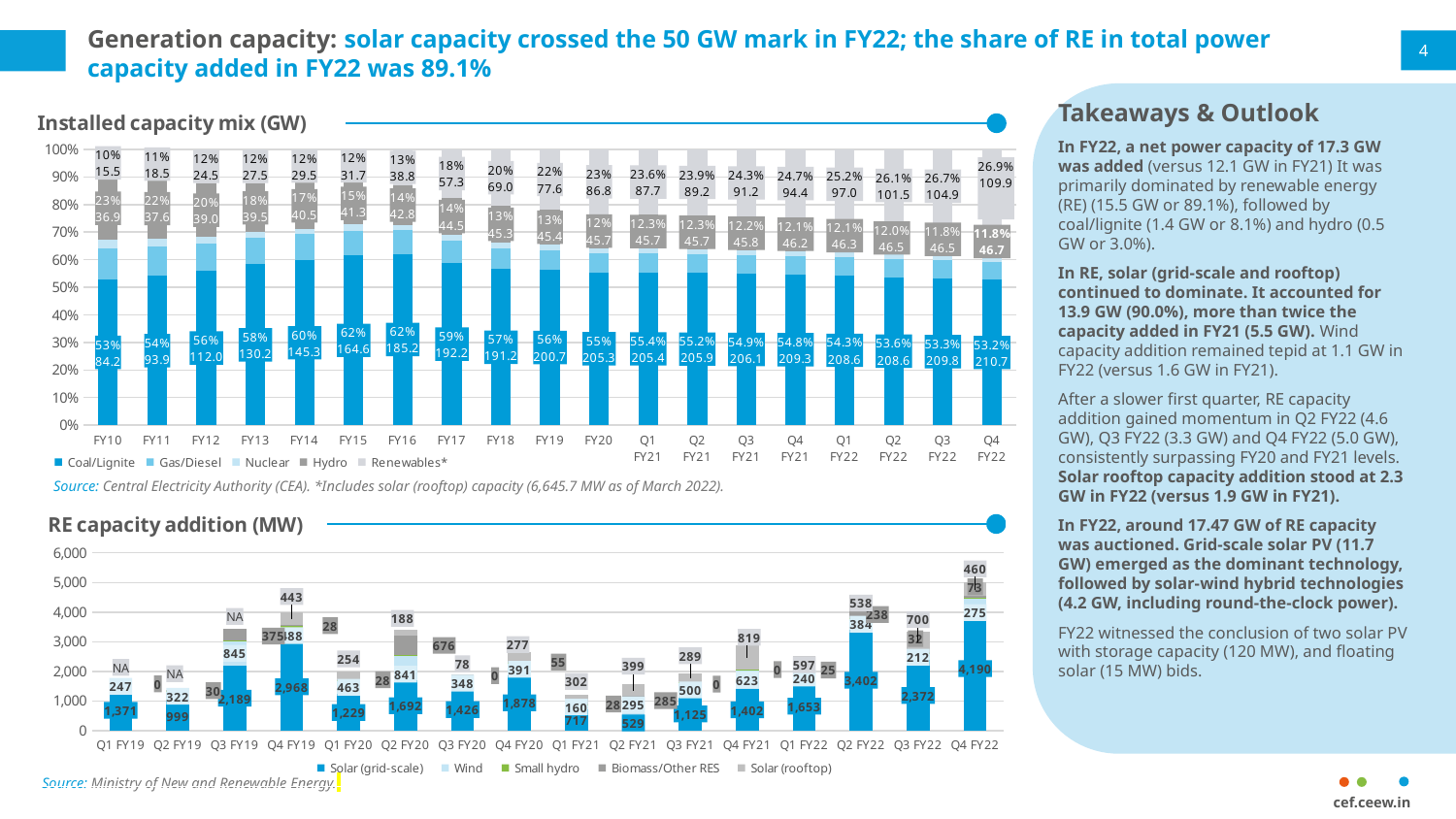
In the 'Installed capacity mix (GW)' chart, what is the Coal/Lignite capacity for FY10? 84.2 In the 'Installed capacity mix (GW)' chart, does the Renewables share rise or fall from FY10 to Q4 FY22? Rise In the 'RE capacity addition (MW)' chart, what is the Solar (rooftop) value for Q4 FY21? 819 What kind of chart is the 'Installed capacity mix (GW)' chart? Stacked bar chart In the 'Installed capacity mix (GW)' chart, how many series does the legend list? 5 In the 'Installed capacity mix (GW)' chart, how many periods are shown on the x axis? 19 In the 'Installed capacity mix (GW)' chart, what percentage share does Renewables have in FY17? 18% In the 'RE capacity addition (MW)' chart, which quarter has the highest Solar (grid-scale) addition? Q4 FY22 In the 'RE capacity addition (MW)' chart, how many quarters are shown on the x axis? 16 In the 'Installed capacity mix (GW)' chart, what is the difference in Renewables capacity between Q4 FY22 and FY10? 94.4 In the 'RE capacity addition (MW)' chart, what is the Solar (grid-scale) value for Q4 FY22? 4,190 In the 'Installed capacity mix (GW)' chart, what is the Renewables capacity for Q4 FY22? 109.9